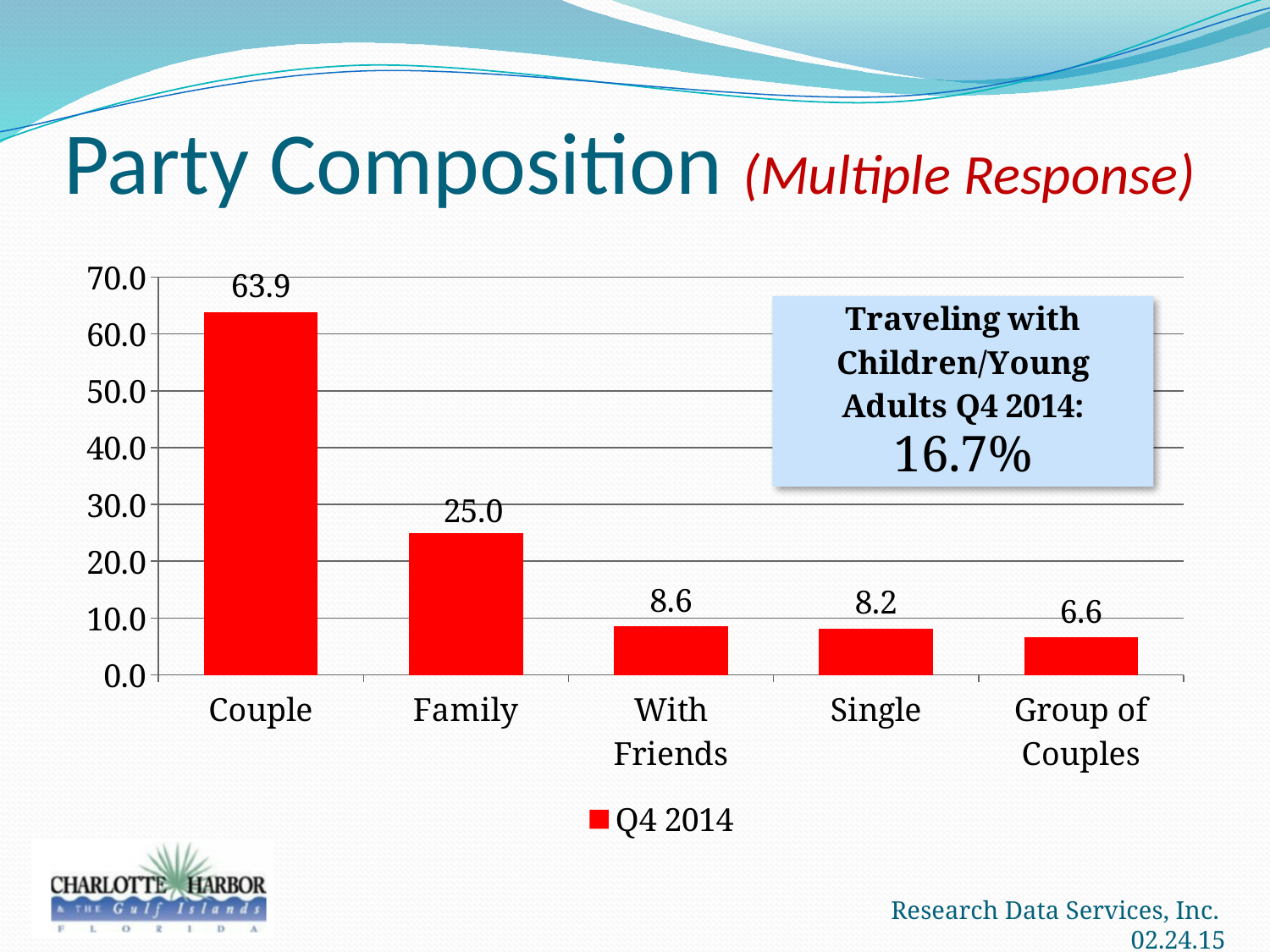
What is the value for Couple? 63.9 Which category has the lowest value? Group of Couples What is the value for Group of Couples? 6.6 How many categories are shown on the x axis? 5 What series does the legend list? Q4 2014 What is the value for With Friends? 8.6 Which category has the highest value? Couple Which is larger, the value for Family or the value for Single? Family What kind of chart is shown on the slide? bar chart What is the difference between the values for Couple and Family? 38.9 What is the value for Family? 25.0 Is the value for Single greater or less than 10.0? less